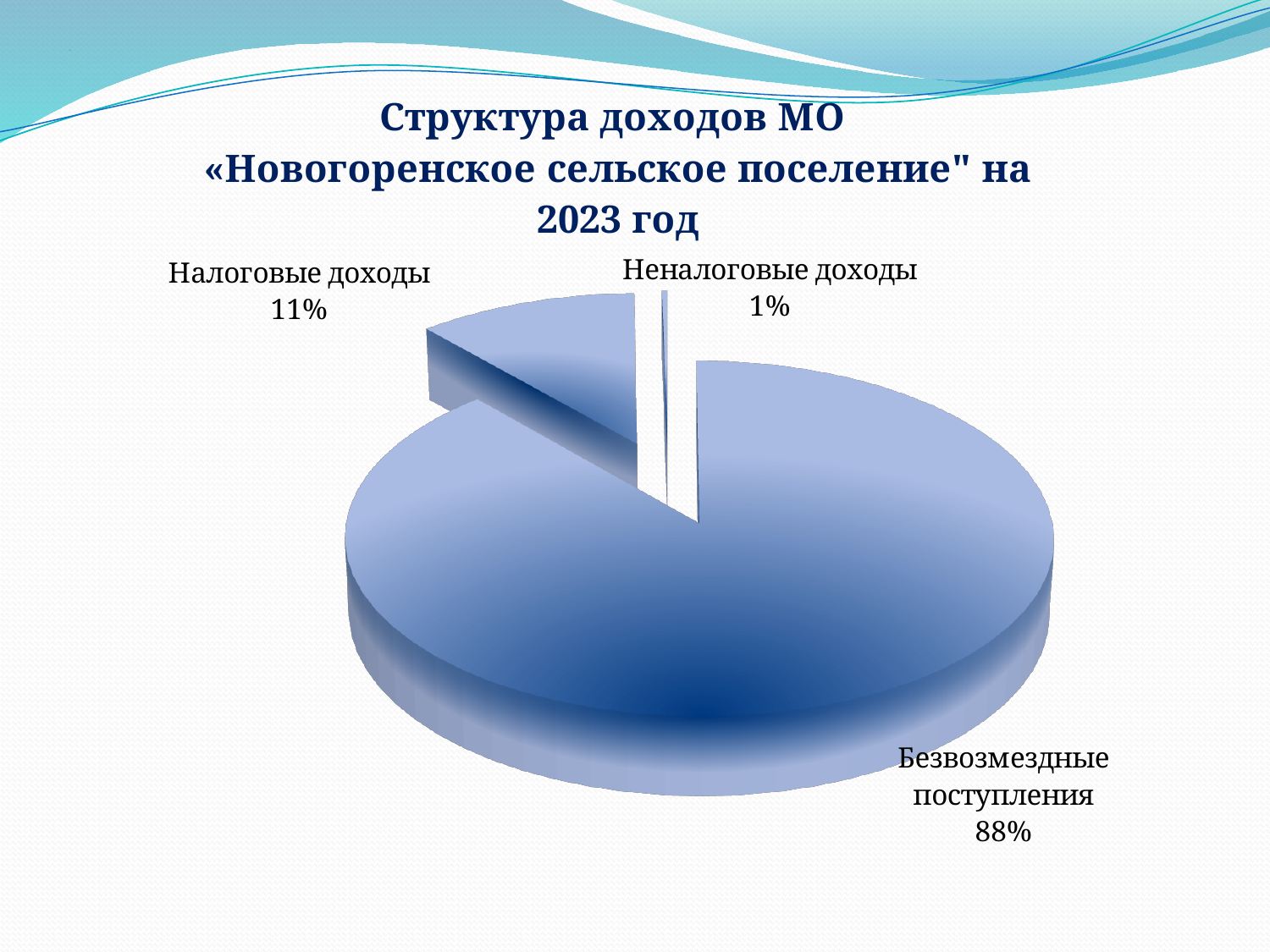
What is the difference in percentage points between Безвозмездные поступления and Налоговые доходы? 77 Which year does the chart title refer to? 2023 Which is larger, the share for Налоговые доходы or the share for Неналоговые доходы? Налоговые доходы What kind of chart is shown on the slide? Pie chart What is the title of the chart? Структура доходов МО «Новогоренское сельское поселение" на 2023 год Which category has the smallest share of the pie? Неналоговые доходы What share of the pie does Налоговые доходы have? 11% How many categories are shown in the pie chart? 3 What share of the pie does Неналоговые доходы have? 1% What is the difference in percentage points between Налоговые доходы and Неналоговые доходы? 10 What share of the pie does Безвозмездные поступления have? 88% Which category has the largest share of the pie? Безвозмездные поступления